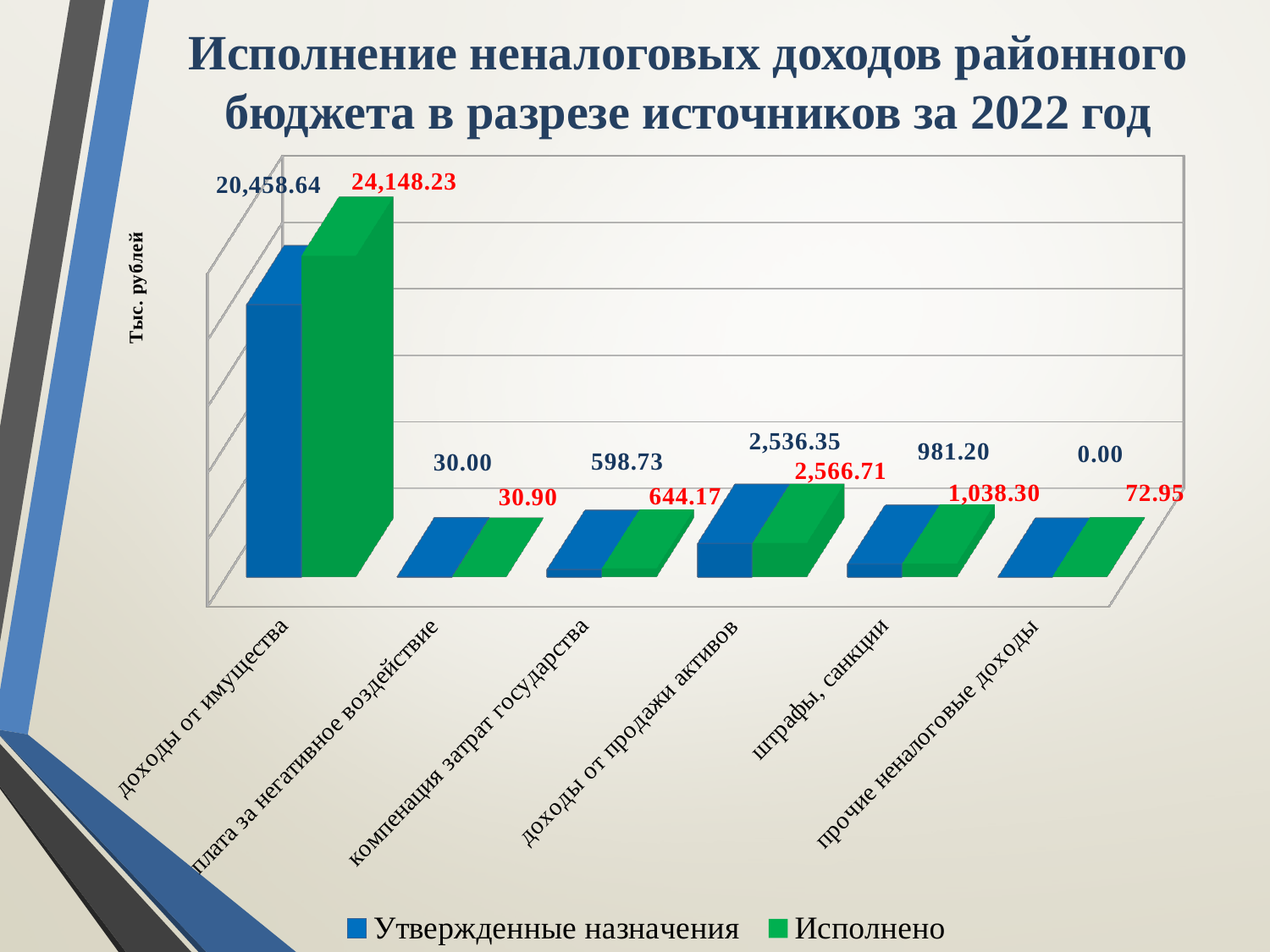
Which category has the lowest Утвержденные назначения value? прочие неналоговые доходы How many categories are shown on the x axis? 6 Which category has the highest Исполнено value? доходы от имущества What is the value of Исполнено for доходы от имущества? 24,148.23 What is the value of Утвержденные назначения for прочие неналоговые доходы? 0.00 Which is larger for доходы от продажи активов: Утвержденные назначения or Исполнено? Исполнено What is the value of Исполнено for штрафы, санкции? 1,038.30 What is the difference between Исполнено and Утвержденные назначения for штрафы, санкции? 57.10 What is the value of Исполнено for компенсация затрат государства? 644.17 What is the difference between Исполнено and Утвержденные назначения for доходы от имущества? 3,689.59 How many series does the legend list? 2 What is the value of Утвержденные назначения for доходы от имущества? 20,458.64